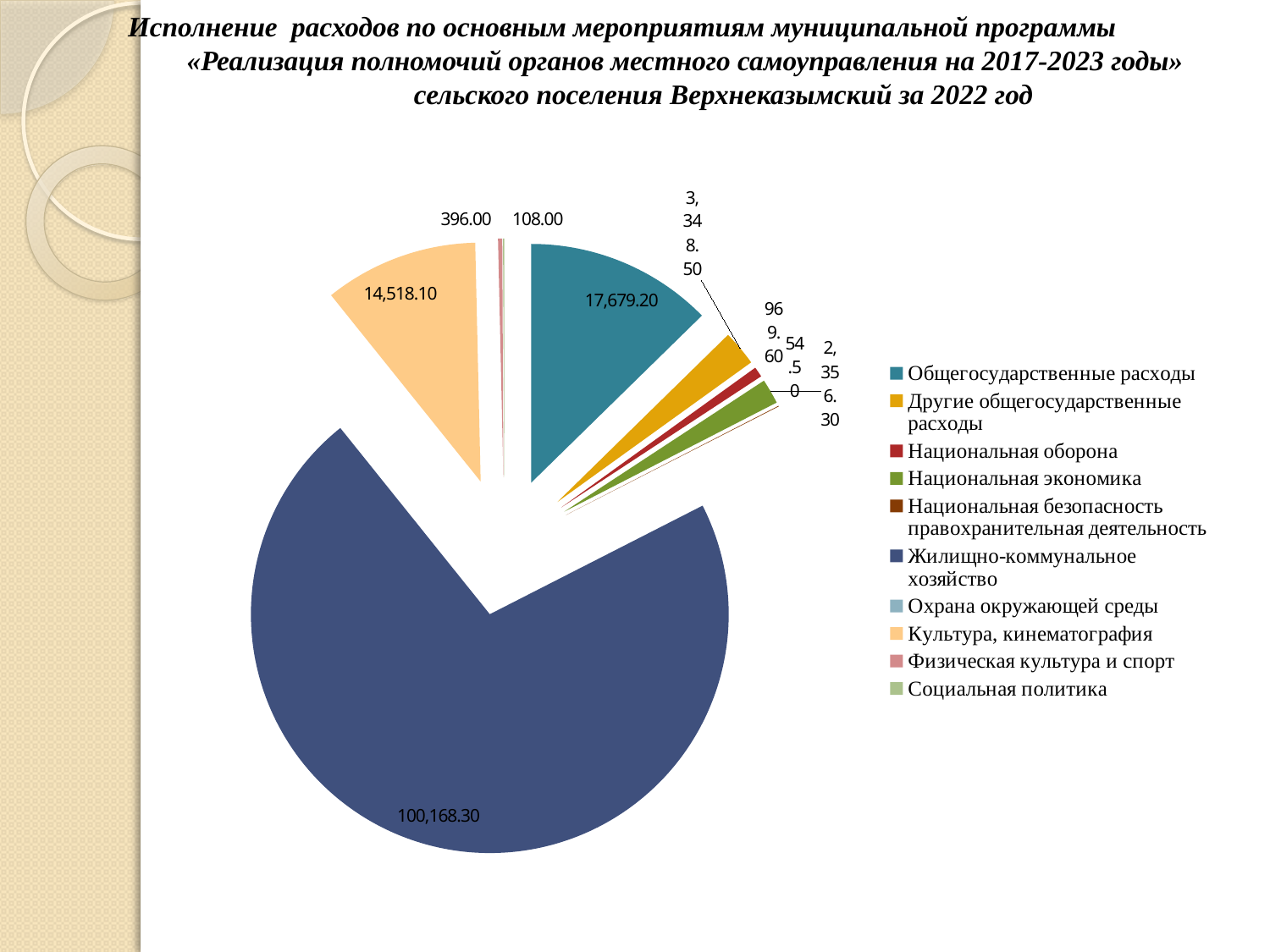
What is the value shown for Жилищно-коммунальное хозяйство? 100,168.30 What is the value shown for Общегосударственные расходы? 17,679.20 Which category has the largest slice of the pie? Жилищно-коммунальное хозяйство What colour is the slice for Жилищно-коммунальное хозяйство? dark blue What kind of chart is shown on the slide? pie chart What is the value shown for Культура, кинематография? 14,518.10 What is the difference between the values for Жилищно-коммунальное хозяйство and Общегосударственные расходы? 82,489.10 Which is larger: Жилищно-коммунальное хозяйство or Культура, кинематография? Жилищно-коммунальное хозяйство How many categories does the legend of the pie chart list? 10 Which is larger: Общегосударственные расходы or Культура, кинематография? Общегосударственные расходы For which year does the chart show the execution of expenditures? 2022 What is the difference between the values for Общегосударственные расходы and Культура, кинематография? 3,161.10